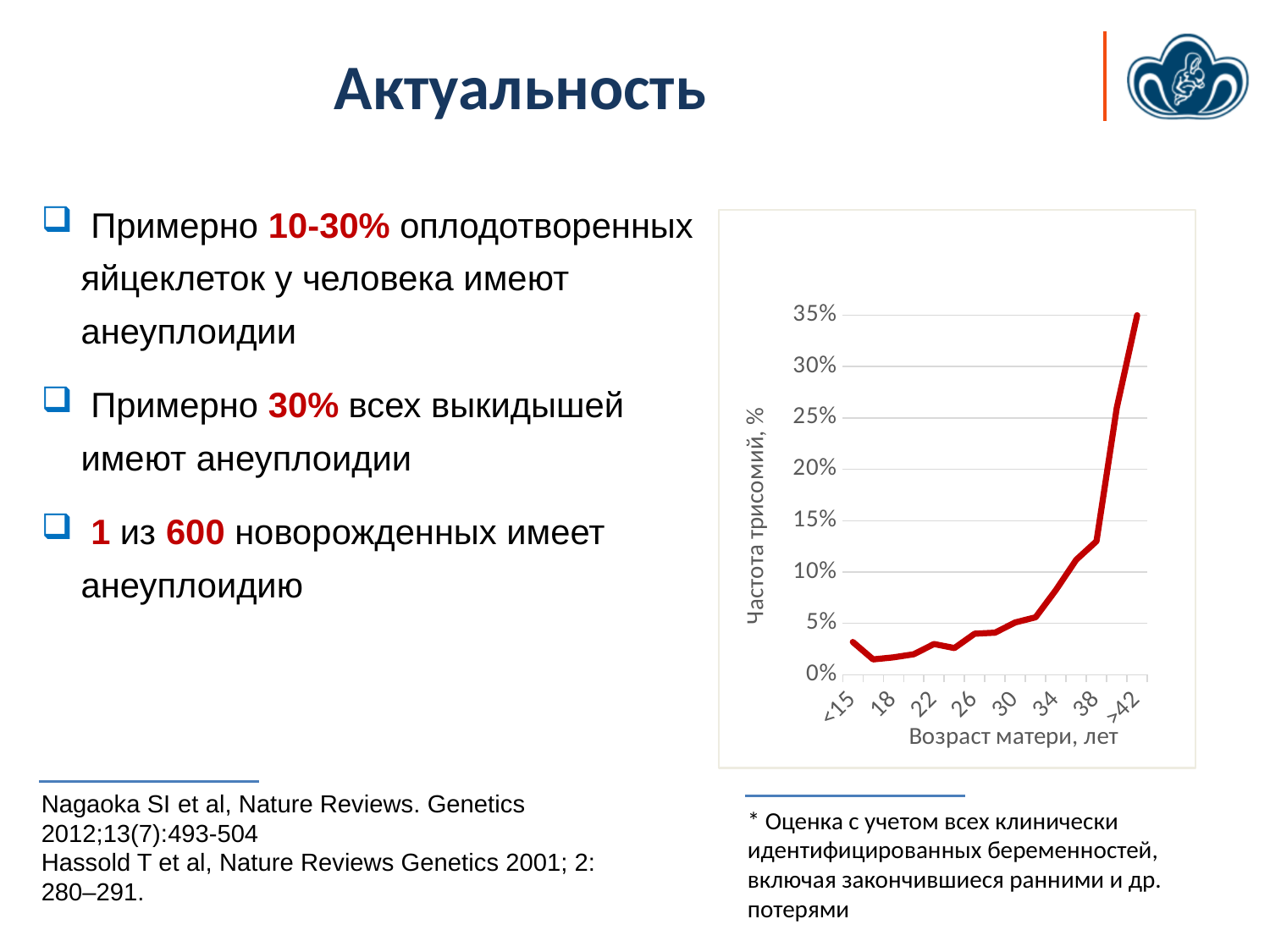
Is the value for 38 greater or less than 10%? greater How many age labels are shown on the horizontal axis? 8 What is the label of the horizontal axis of the chart? Возраст матери, лет Does the trisomy frequency generally rise or fall as maternal age increases along the x axis? rise Which has a larger trisomy frequency, <15 or >42? >42 Is the value for >42 greater or less than 30%? greater What is the label of the vertical axis of the chart? Частота трисомий, % Is the value for <15 greater or less than 5%? less Which maternal age category has the highest trisomy frequency? >42 What kind of chart is shown on the slide? line chart Which has a larger trisomy frequency, 26 or 38? 38